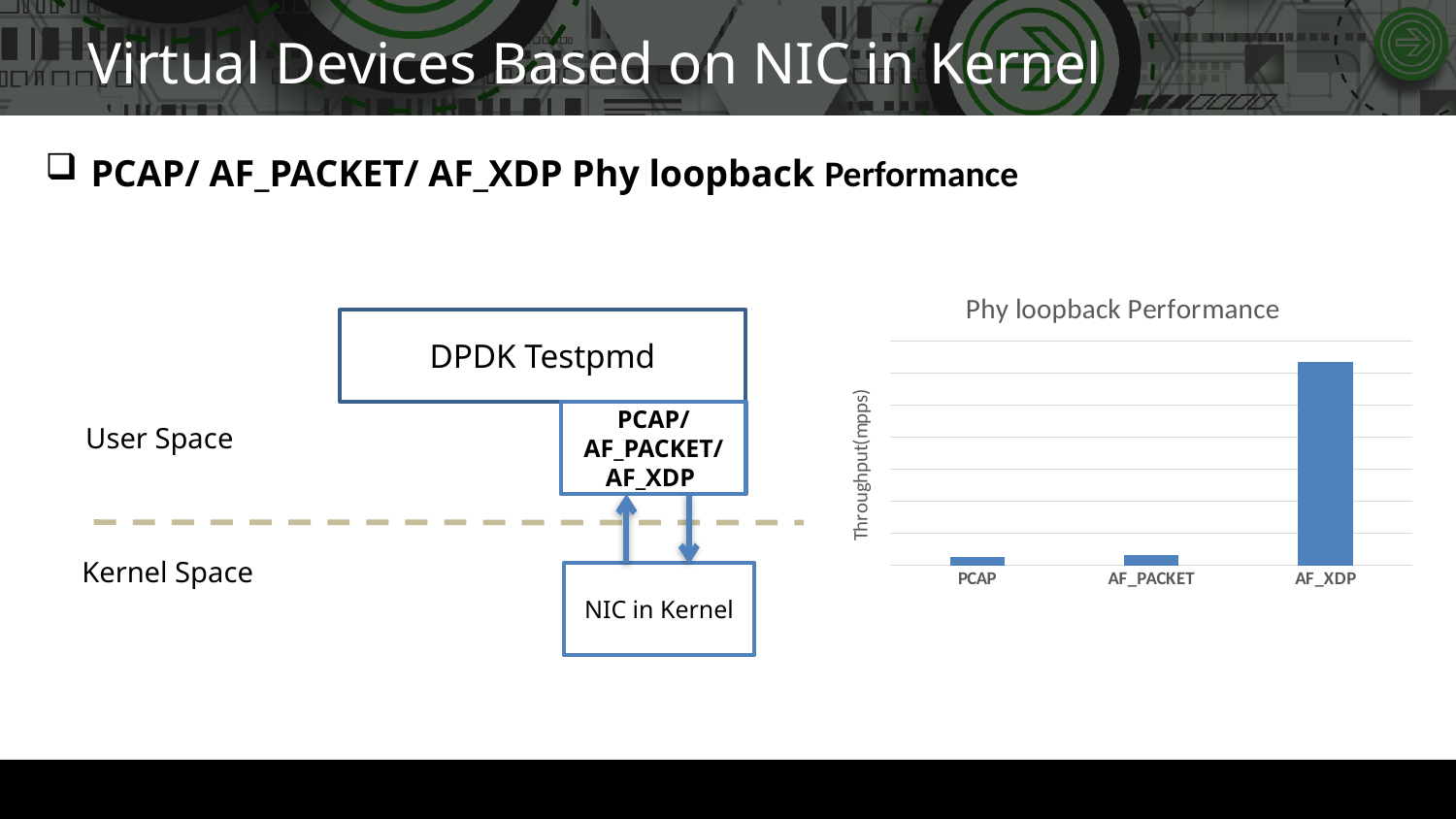
What is the title of the chart? Phy loopback Performance How many categories are plotted in the chart? 3 What type of chart is shown on the slide? bar chart Which has the larger throughput, PCAP or AF_XDP? AF_XDP What is the label on the vertical axis of the chart? Throughput(mpps) Which has the larger throughput, AF_PACKET or AF_XDP? AF_XDP Which category has the highest throughput in the chart? AF_XDP Do the throughput values rise or fall from left to right across the categories? rise